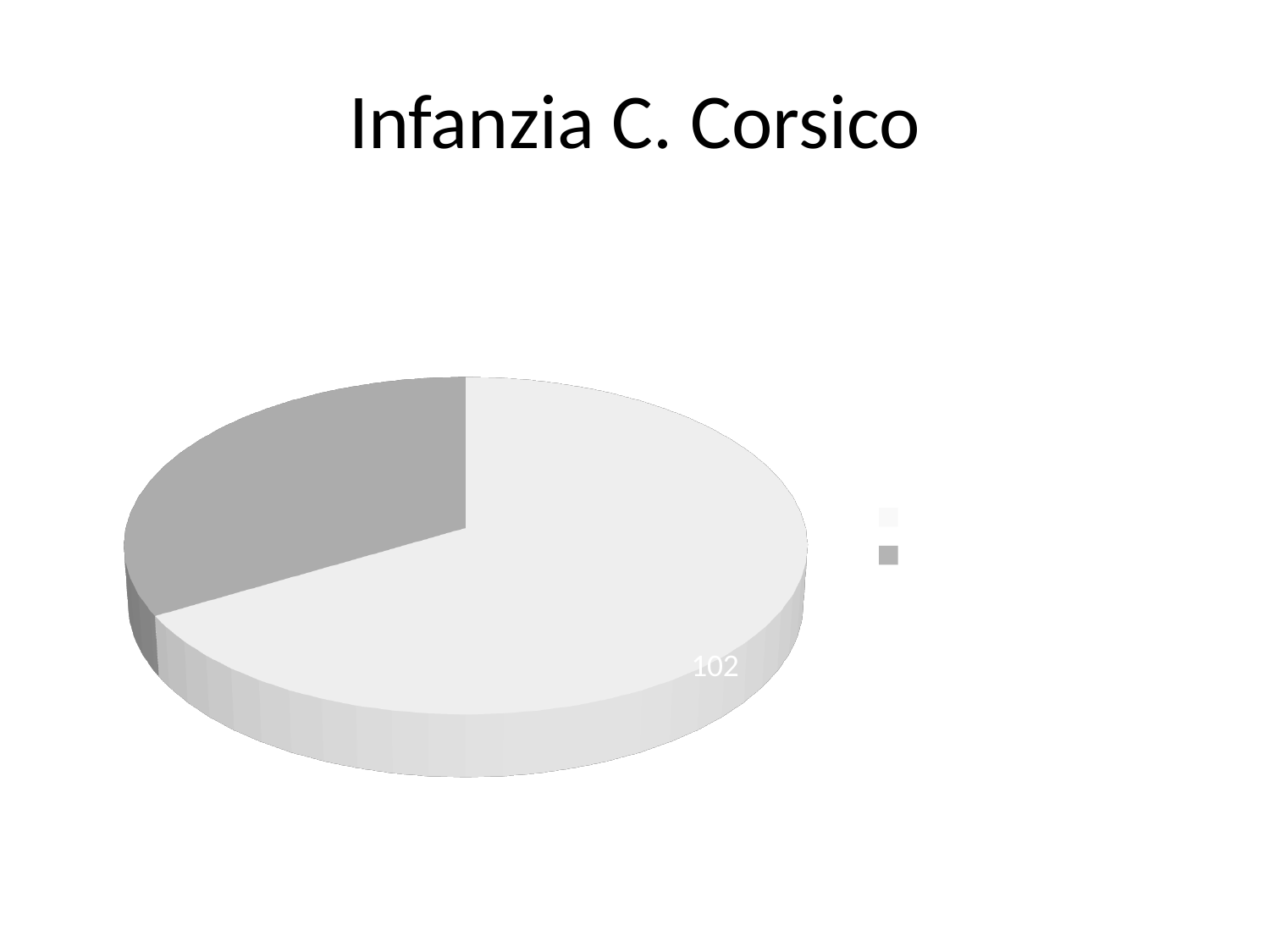
What kind of chart is shown on the slide? pie chart Is the value of the light grey slice greater or less than 100? greater What is the title of the chart? Infanzia C. Corsico Which slice of the pie is the largest? the light grey slice How many entries does the legend list? 2 Does the light grey slice take up more or less than half of the pie? more Which slice is larger, the light grey one or the dark grey one? the light grey one How many slices does the pie chart have? 2 Which slice of the pie is the smallest? the dark grey slice What value is printed on the larger (light grey) slice of the pie? 102